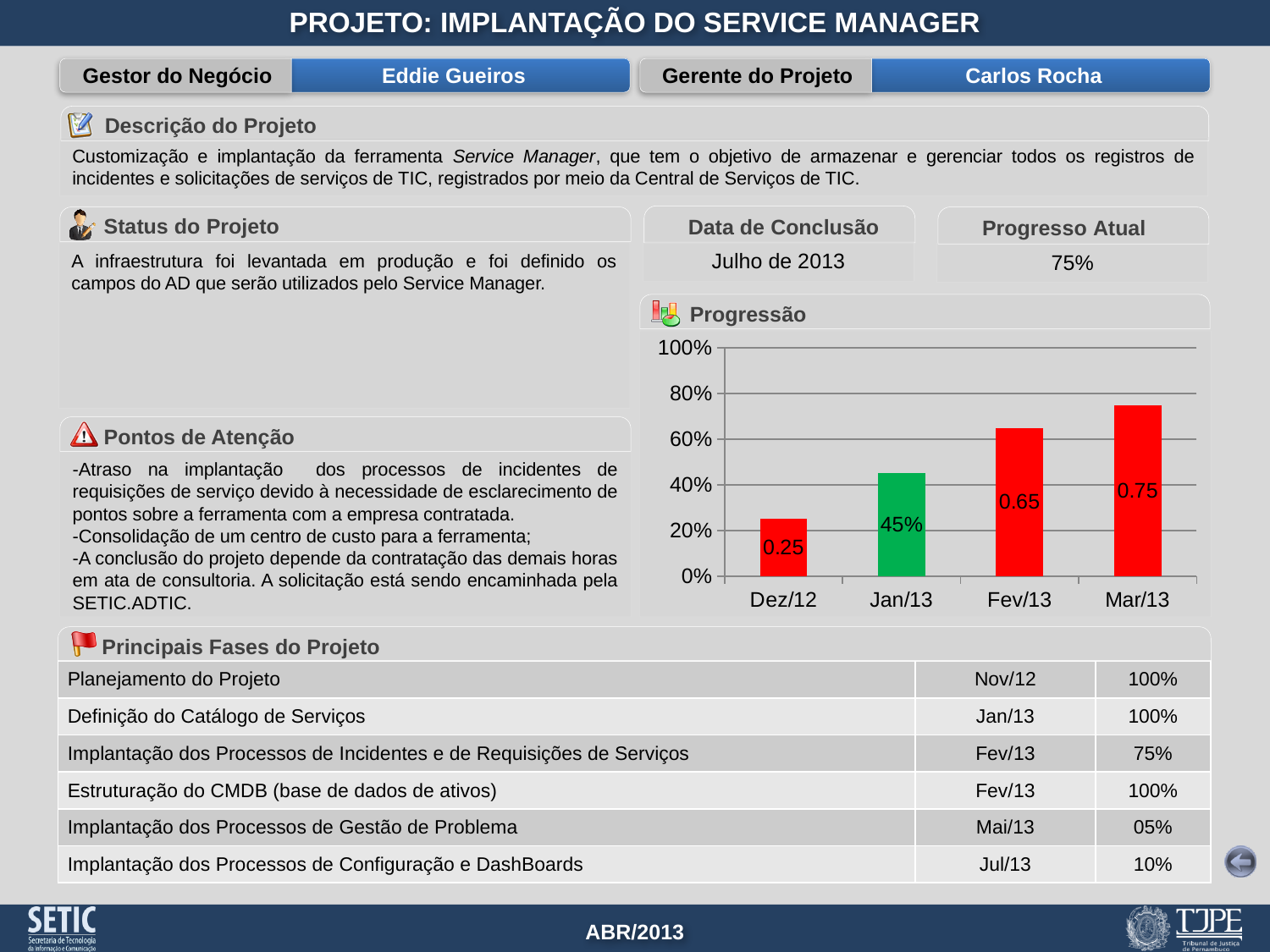
Do the values in the Progressão chart rise or fall from Dez/12 to Mar/13? rise In the Progressão chart, is the value for Fev/13 greater or less than 60%? greater What colour is the Jan/13 bar in the Progressão chart? green Which month has the lowest bar in the Progressão chart? Dez/12 How many months are plotted in the Progressão chart? 4 What is the value shown for Fev/13 in the Progressão chart? 0.65 What is the value shown for Mar/13 in the Progressão chart? 0.75 What is the value shown for Jan/13 in the Progressão chart? 45% What kind of chart is the Progressão chart? bar chart Which month has the highest bar in the Progressão chart? Mar/13 What is the value shown for Dez/12 in the Progressão chart? 0.25 In the Progressão chart, which is larger, the value for Fev/13 or the value for Jan/13? Fev/13